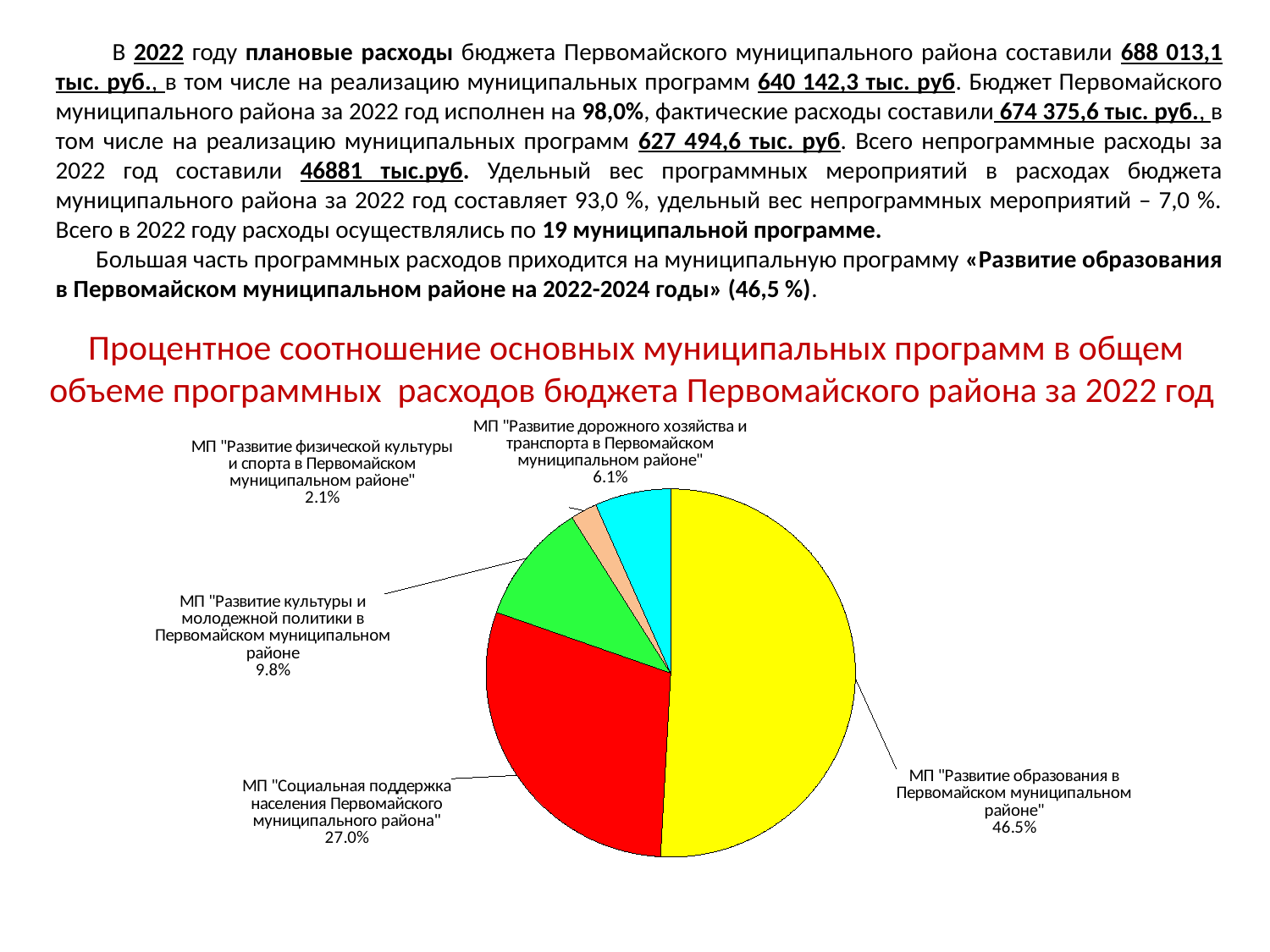
Which municipal programme has the largest share in the pie chart? МП "Развитие образования в Первомайском муниципальном районе" What percentage is shown for the MP "Развитие дорожного хозяйства и транспорта в Первомайском муниципальном районе"? 6.1% Which has a larger share: the culture and youth policy programme or the road economy and transport programme? МП "Развитие культуры и молодежной политики в Первомайском муниципальном районе" What percentage is shown for the MP "Социальная поддержка населения Первомайского муниципального района"? 27.0% What share of programme expenditures does the MP "Развитие образования в Первомайском муниципальном районе" account for? 46.5% What is the difference in percentage points between the education programme and the social support programme? 19.5 How many slices does the pie chart have? 5 What colour is the slice for the MP "Социальная поддержка населения Первомайского муниципального района"? red What percentage is shown for the MP "Развитие культуры и молодежной политики в Первомайском муниципальном районе"? 9.8% What type of chart is shown on the slide? pie chart Which municipal programme has the smallest share in the pie chart? МП "Развитие физической культуры и спорта в Первомайском муниципальном районе" What percentage is shown for the MP "Развитие физической культуры и спорта в Первомайском муниципальном районе"? 2.1%